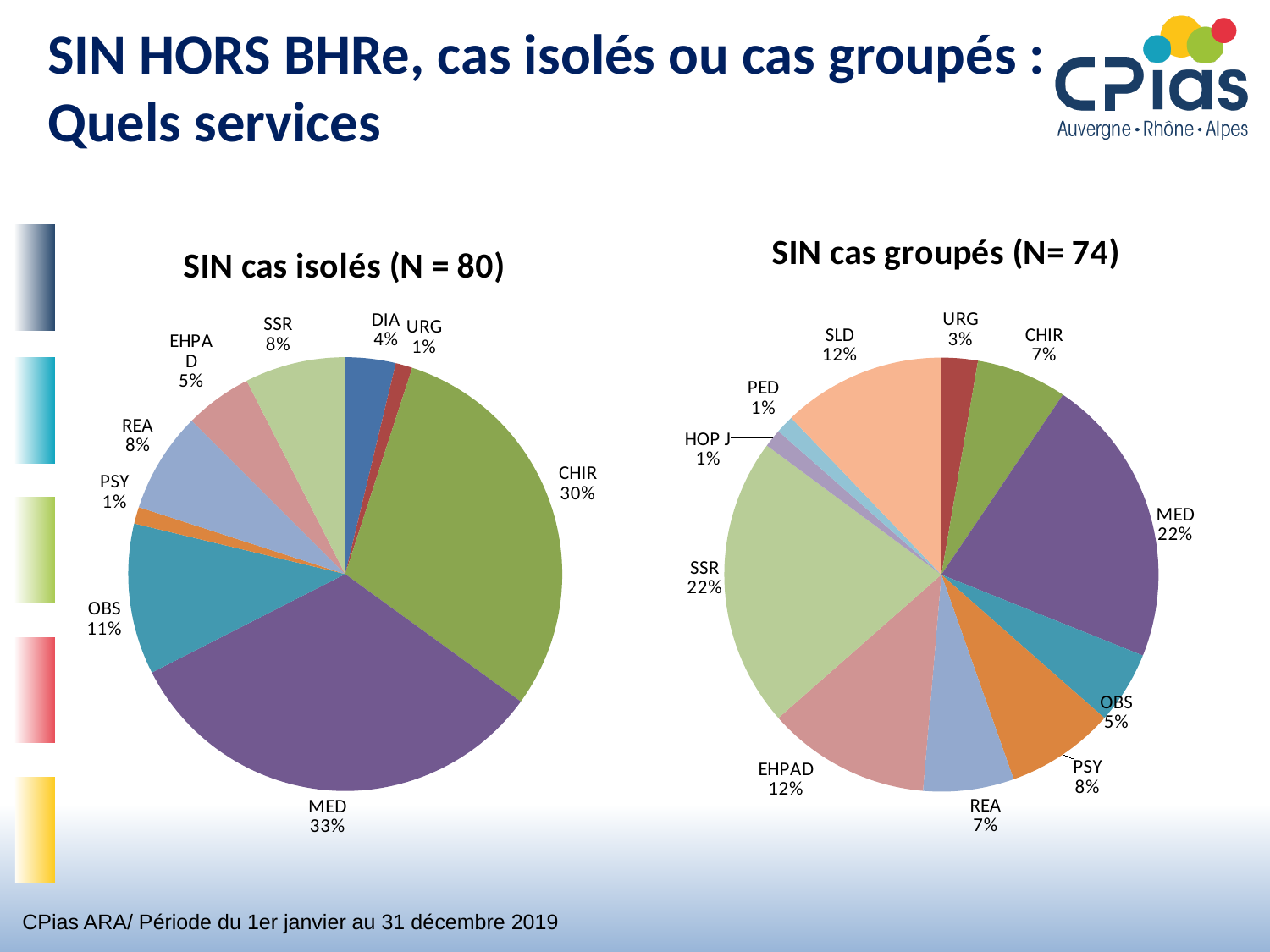
In the 'SIN cas groupés (N= 74)' chart, which is larger, the PSY share or the REA share? PSY In the 'SIN cas isolés (N = 80)' chart, what share does CHIR have? 30% What is the title of the chart on the right of the slide? SIN cas groupés (N= 74) What kind of chart is used on the left of the slide? Pie chart In the 'SIN cas groupés (N= 74)' chart, how many slices does the pie have? 11 In the 'SIN cas groupés (N= 74)' chart, what share does SSR have? 22% In the 'SIN cas groupés (N= 74)' chart, what is the difference between the MED share and the CHIR share? 15% In the 'SIN cas isolés (N = 80)' chart, what is the difference between the OBS share and the REA share? 3% In the 'SIN cas groupés (N= 74)' chart, what share does EHPAD have? 12% In the 'SIN cas isolés (N = 80)' chart, how many slices does the pie have? 9 In the 'SIN cas isolés (N = 80)' chart, which service has the largest slice? MED